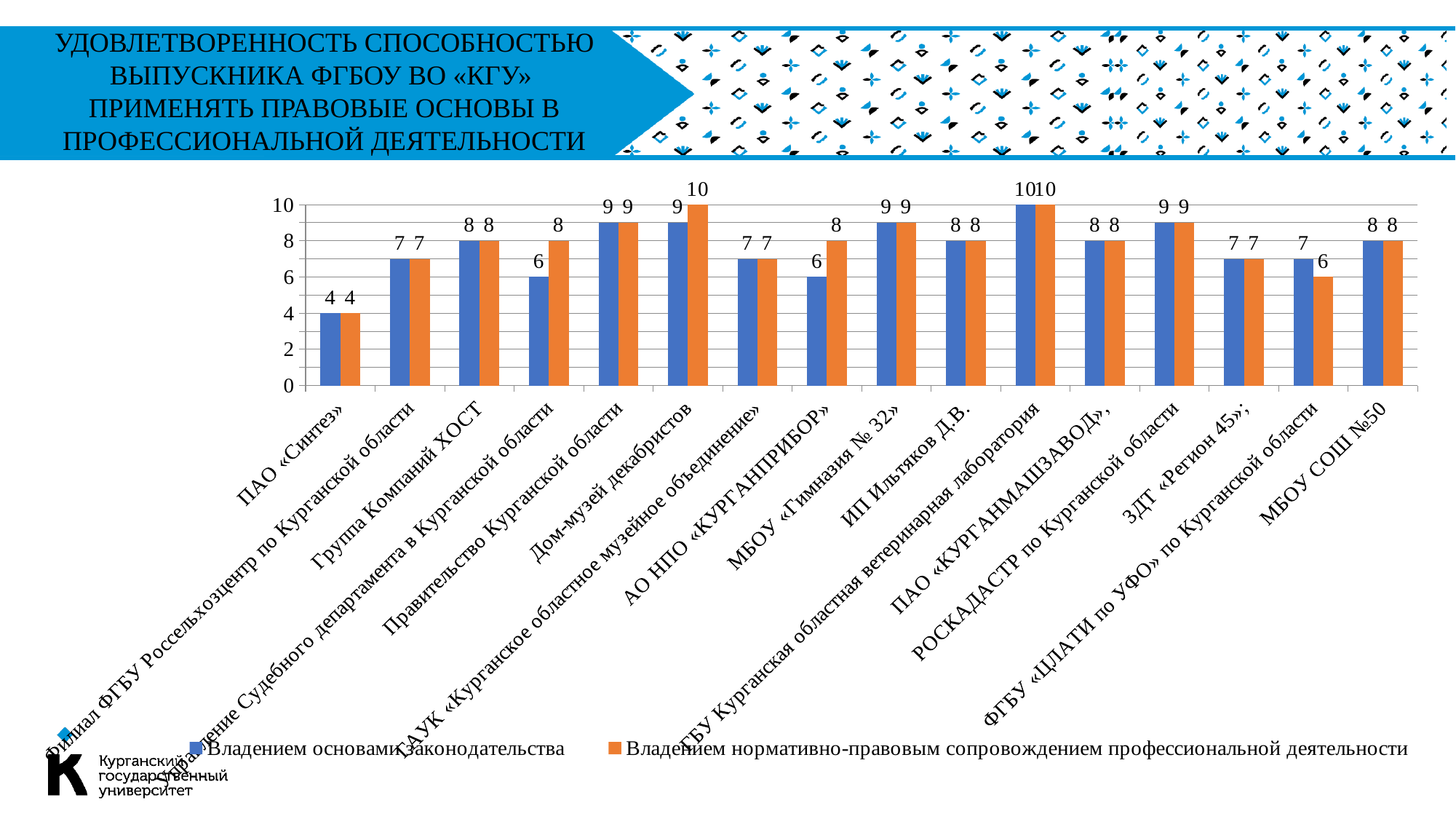
For ФГБУ «ЦЛАТИ по УФО» по Курганской области, which series has the larger value? Владением основами законодательства What is the value for АО НПО «КУРГАНПРИБОР» in the series «Владением основами законодательства»? 6 Which category has the highest value in the series «Владением основами законодательства»? ГБУ Курганская областная ветеринарная лаборатория How many categories are shown on the x axis of the chart? 16 How many series does the legend list? 2 What is the value for ПАО «Синтез» in the series «Владением основами законодательства»? 4 What kind of chart is shown on the slide? bar chart Is the value for Правительство Курганской области in the series «Владением основами законодательства» greater or less than 8? greater What is the value for Дом-музей декабристов in the series «Владением нормативно-правовым сопровождением профессиональной деятельности»? 10 Which colour represents the series «Владением нормативно-правовым сопровождением профессиональной деятельности»? orange Which category has the lowest value in the series «Владением основами законодательства»? ПАО «Синтез» What is the difference between the two series values for Управление Судебного департамента в Курганской области? 2